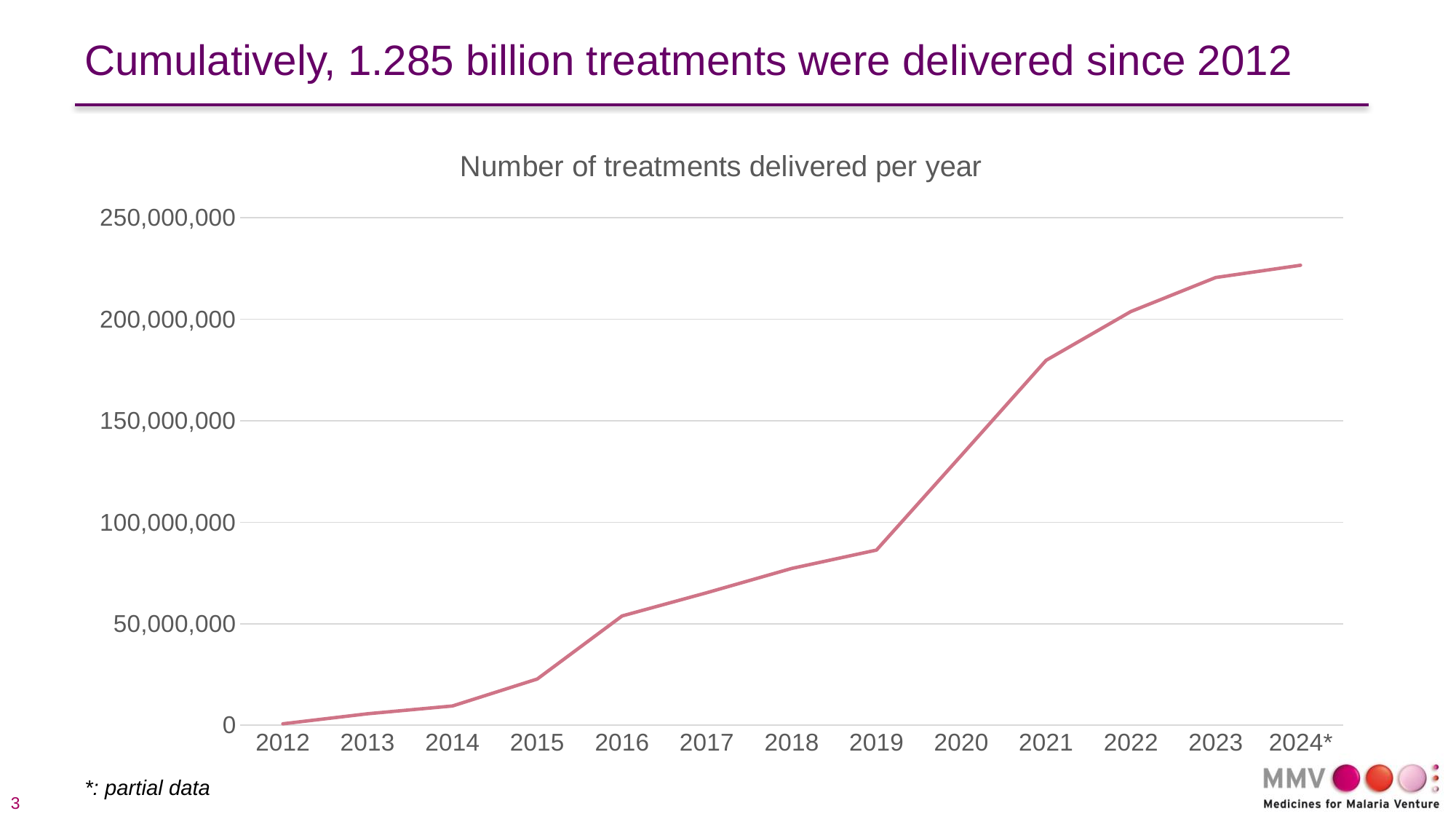
Is the value for 2021 greater or less than 150,000,000? greater Is the value for 2019 greater or less than 100,000,000? less Is the value for 2016 greater or less than 50,000,000? greater How many years are plotted on the x axis of the chart? 13 Which year has the larger value, 2018 or 2020? 2020 What kind of chart is shown on the slide? line chart Do the values rise or fall from 2012 to 2024*? rise What is the highest value shown on the y axis of the chart? 250,000,000 What is the title of the chart? Number of treatments delivered per year Which year has the lowest number of treatments delivered? 2012 Which year has the highest number of treatments delivered? 2024*